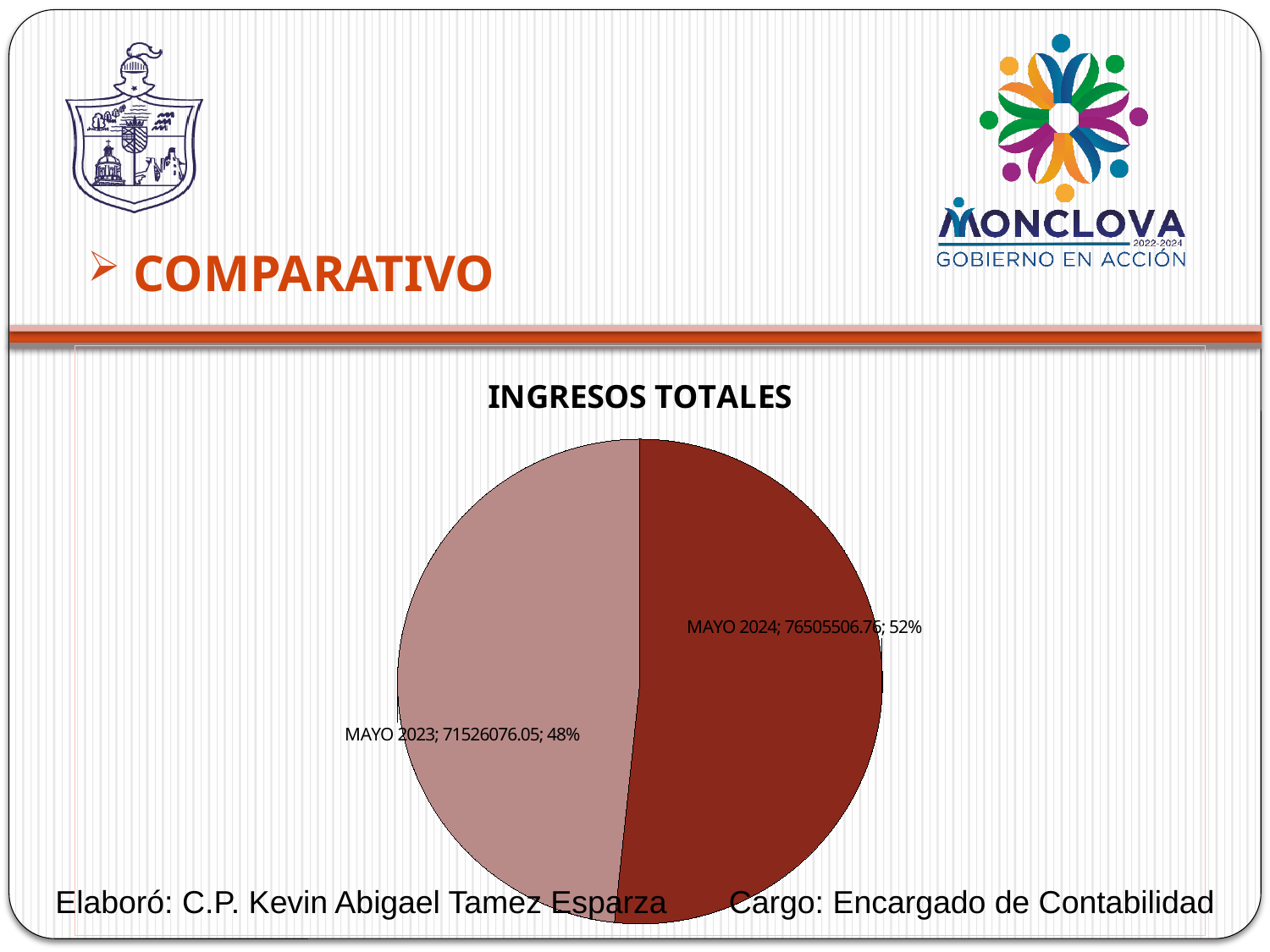
What is the value for MAYO 2023? 71526076.05 Which slice is the smallest? MAYO 2023 What type of chart is shown on the slide? pie chart What share of the pie does MAYO 2024 represent? 52% Which is larger, the value for MAYO 2024 or MAYO 2023? MAYO 2024 Which slice is drawn in the darker red colour? MAYO 2024 What is the value for MAYO 2024? 76505506.76 Which slice is the largest? MAYO 2024 What is the difference between the values for MAYO 2024 and MAYO 2023? 4979430.71 What is the title of the chart? INGRESOS TOTALES What share of the pie does MAYO 2023 represent? 48% How many slices does the pie chart have? 2